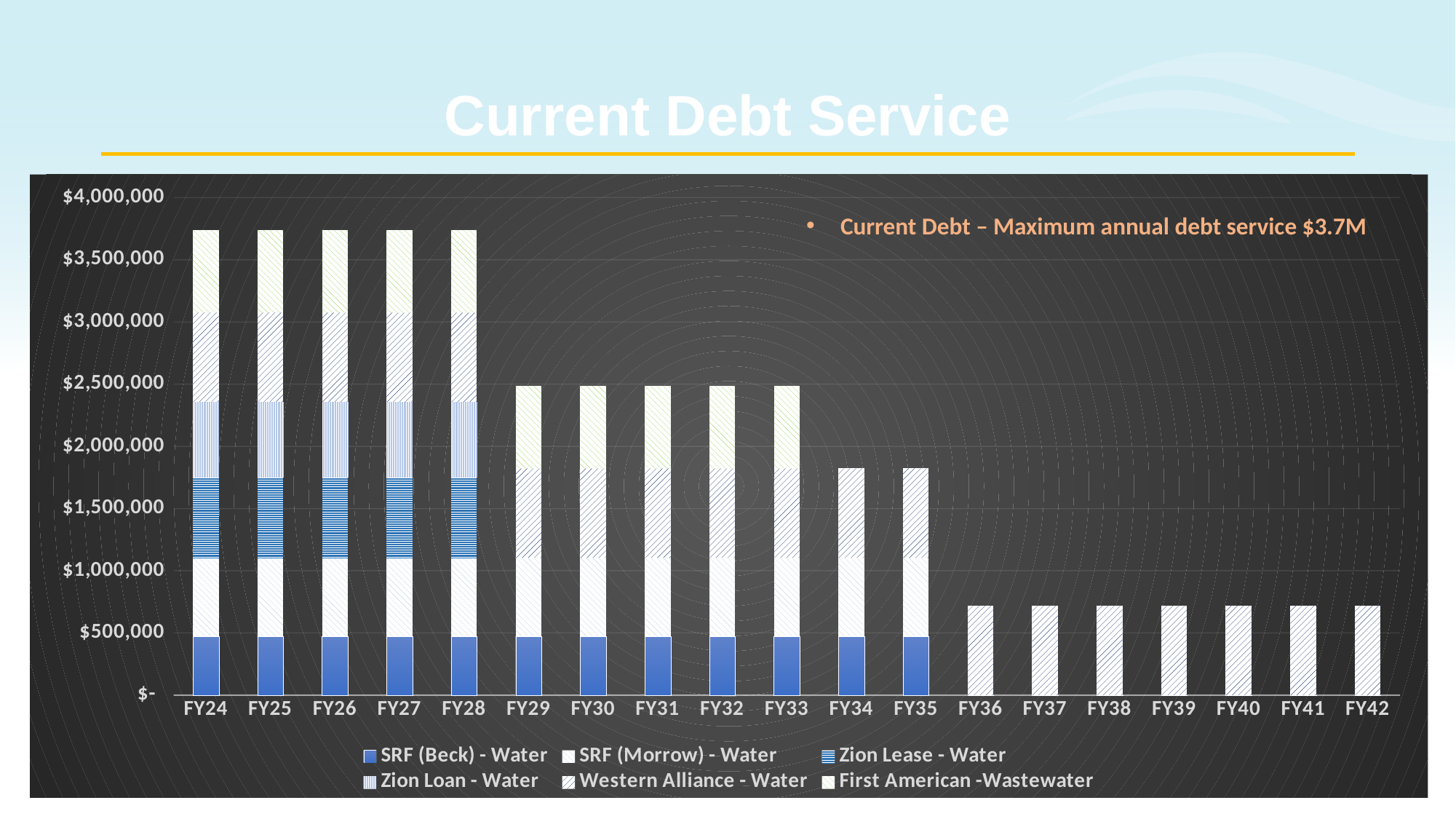
How many fiscal years are shown along the x axis? 19 Do the total debt service values generally rise or fall from FY24 to FY42? fall What kind of chart is shown on the slide? Stacked bar chart How many series does the legend list? 6 Is the total debt service for FY40 greater or less than $500,000? greater Is the total debt service for FY34 greater or less than $2,000,000? less Is the total debt service for FY24 greater or less than $3,500,000? greater Which has the larger total debt service, FY28 or FY29? FY28 What is the title of the chart? Current Debt Service According to the text on the slide, what is the maximum annual debt service for current debt? $3.7M